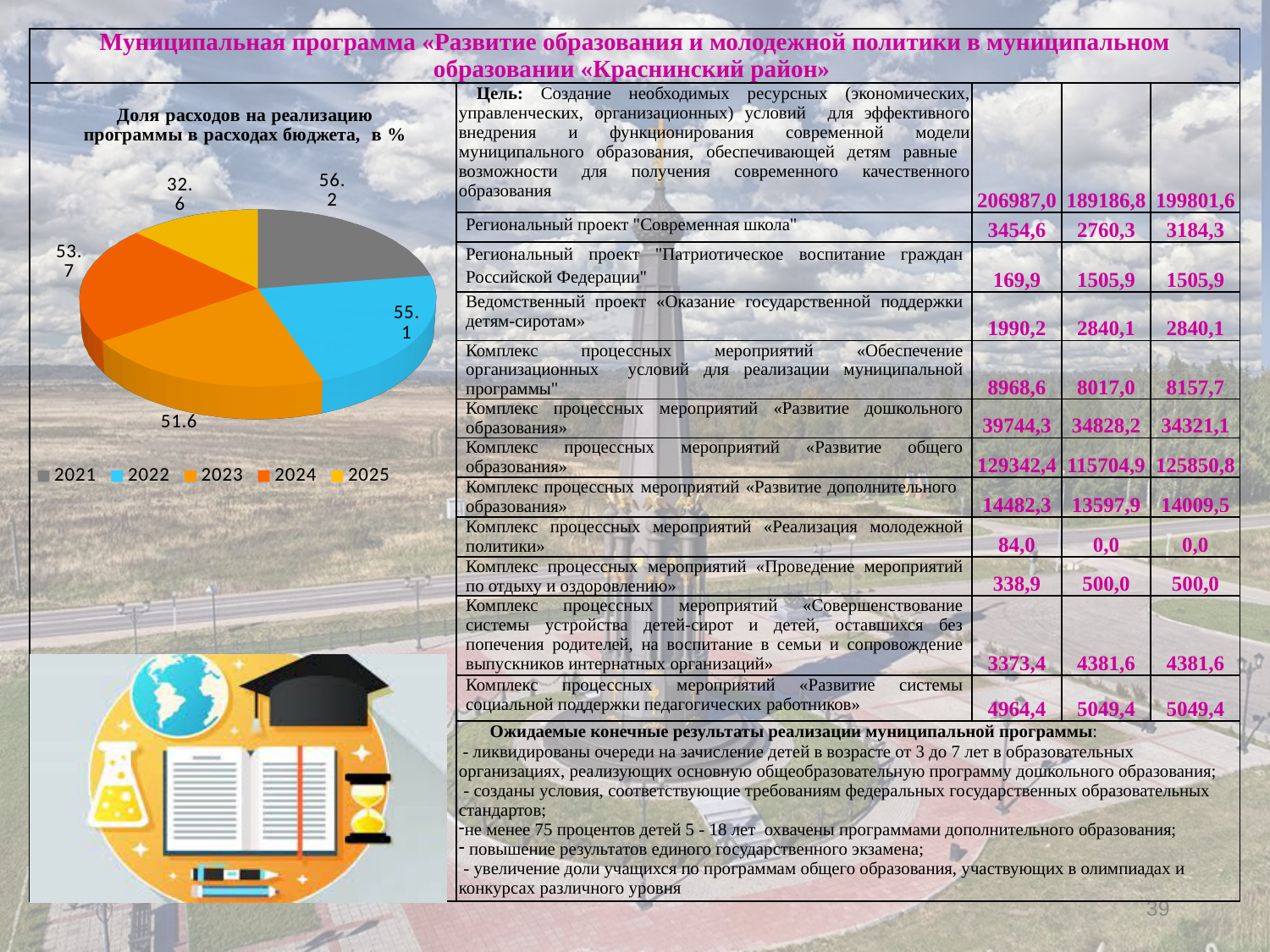
What is the value shown for 2024 in the pie chart? 53.7 How many years does the legend of the pie chart list? 5 What is the title of the pie chart? Доля расходов на реализацию программы в расходах бюджета, в % What is the value shown for 2023 in the pie chart? 51.6 Which year has the largest value in the pie chart? 2021 What is the value shown for 2021 in the pie chart? 56.2 What is the difference between the values for 2021 and 2025 in the pie chart? 23.6 Which has the larger value in the pie chart, 2022 or 2024? 2022 What is the difference between the values for 2022 and 2023 in the pie chart? 3.5 What kind of chart is shown on the slide? pie chart What is the value shown for 2025 in the pie chart? 32.6 Which year has the smallest value in the pie chart? 2025